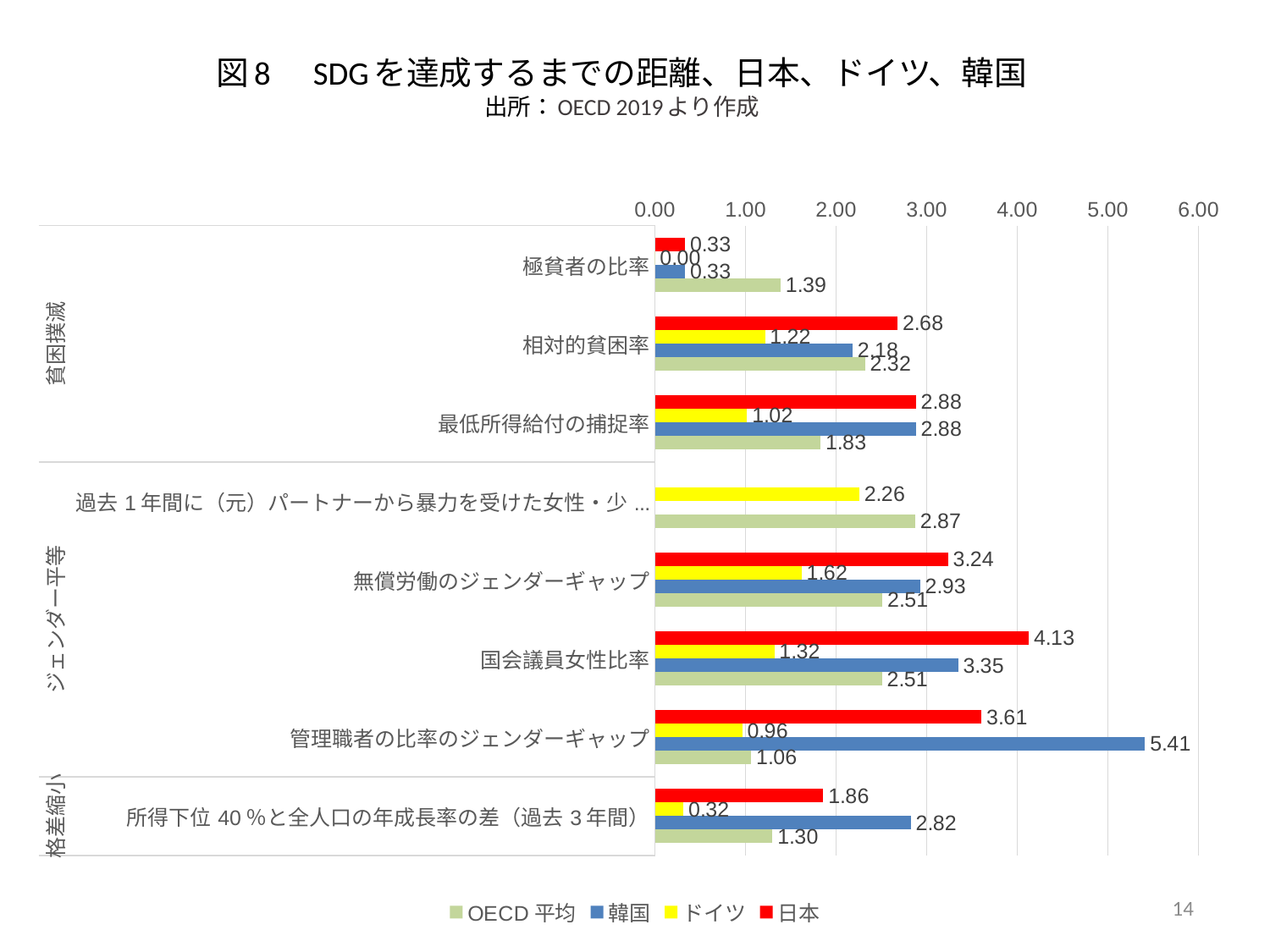
Which series has the lowest value in the 所得下位 40％と全人口の年成長率の差（過去 3 年間） category? ドイツ What is the value for 韓国 in the 管理職者の比率のジェンダーギャップ category? 5.41 Which colour represents 日本 in the chart? Red What is the OECD 平均 value for 極貧者の比率? 1.39 What is the difference between the 日本 and ドイツ values for 無償労働のジェンダーギャップ? 1.62 Which country or series has the highest value in the 管理職者の比率のジェンダーギャップ category? 韓国 What kind of chart is shown on the slide? Bar chart What is the value for ドイツ in the 相対的貧困率 category? 1.22 What is the value for 日本 in the 国会議員女性比率 category? 4.13 How many categories are shown on the vertical axis of the chart? 8 Which is larger for 相対的貧困率: the value for 韓国 or the value for OECD 平均? OECD 平均 How many series does the legend list? 4